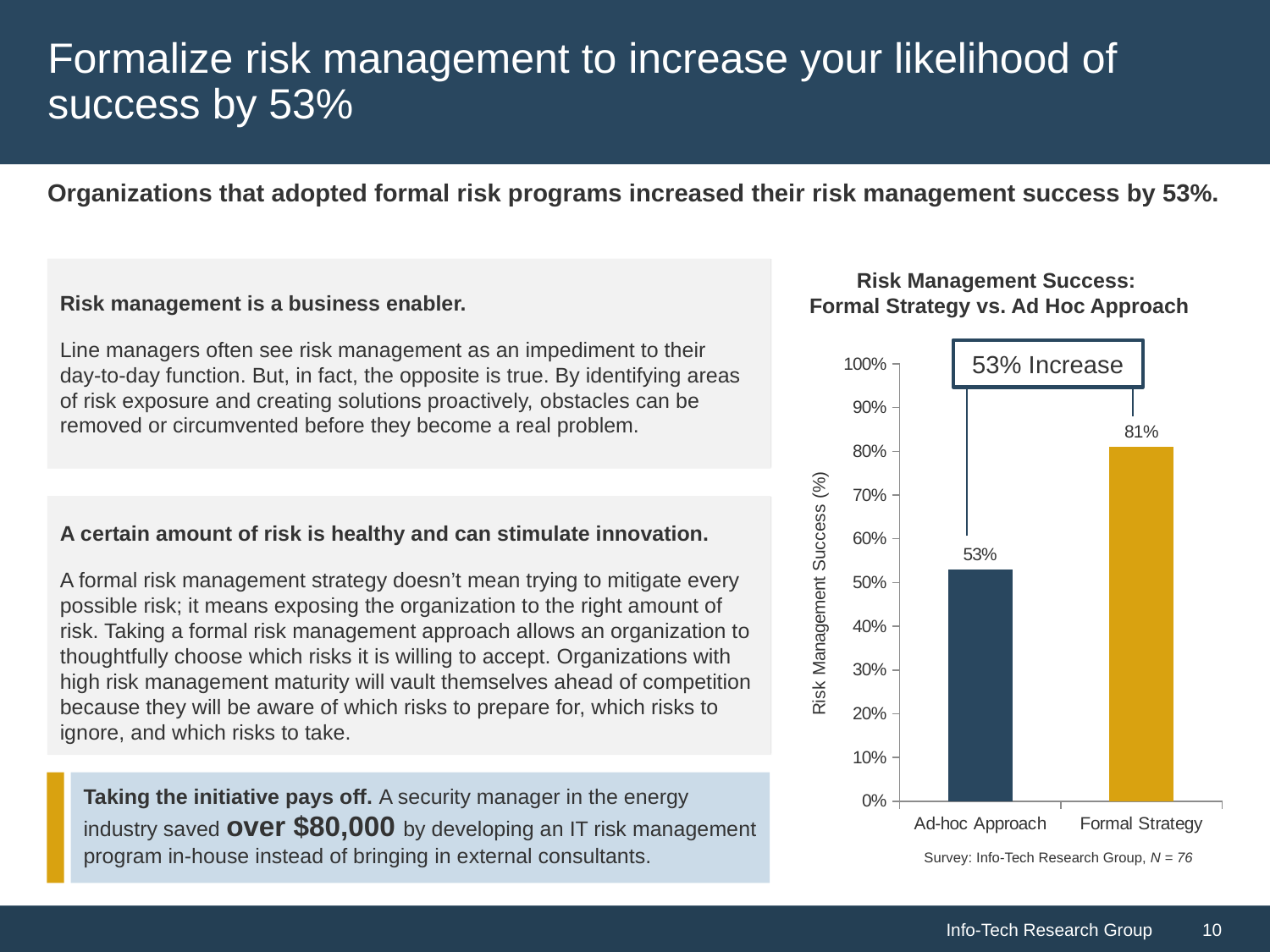
What is the title of the chart? Risk Management Success: Formal Strategy vs. Ad Hoc Approach What does the annotation box above the bars say? 53% Increase Which category has the highest Risk Management Success? Formal Strategy What kind of chart is shown on the slide? Bar chart What is the Risk Management Success value for the Ad-hoc Approach? 53% What is the difference in Risk Management Success between the Formal Strategy and the Ad-hoc Approach? 28% Is the value for the Formal Strategy greater or less than 70%? greater Which is larger, the value for the Ad-hoc Approach or the value for the Formal Strategy? Formal Strategy How many categories are shown on the x axis of the chart? 2 Which category has the lowest Risk Management Success? Ad-hoc Approach Is the value for the Ad-hoc Approach greater or less than 60%? less What is the Risk Management Success value for the Formal Strategy? 81%